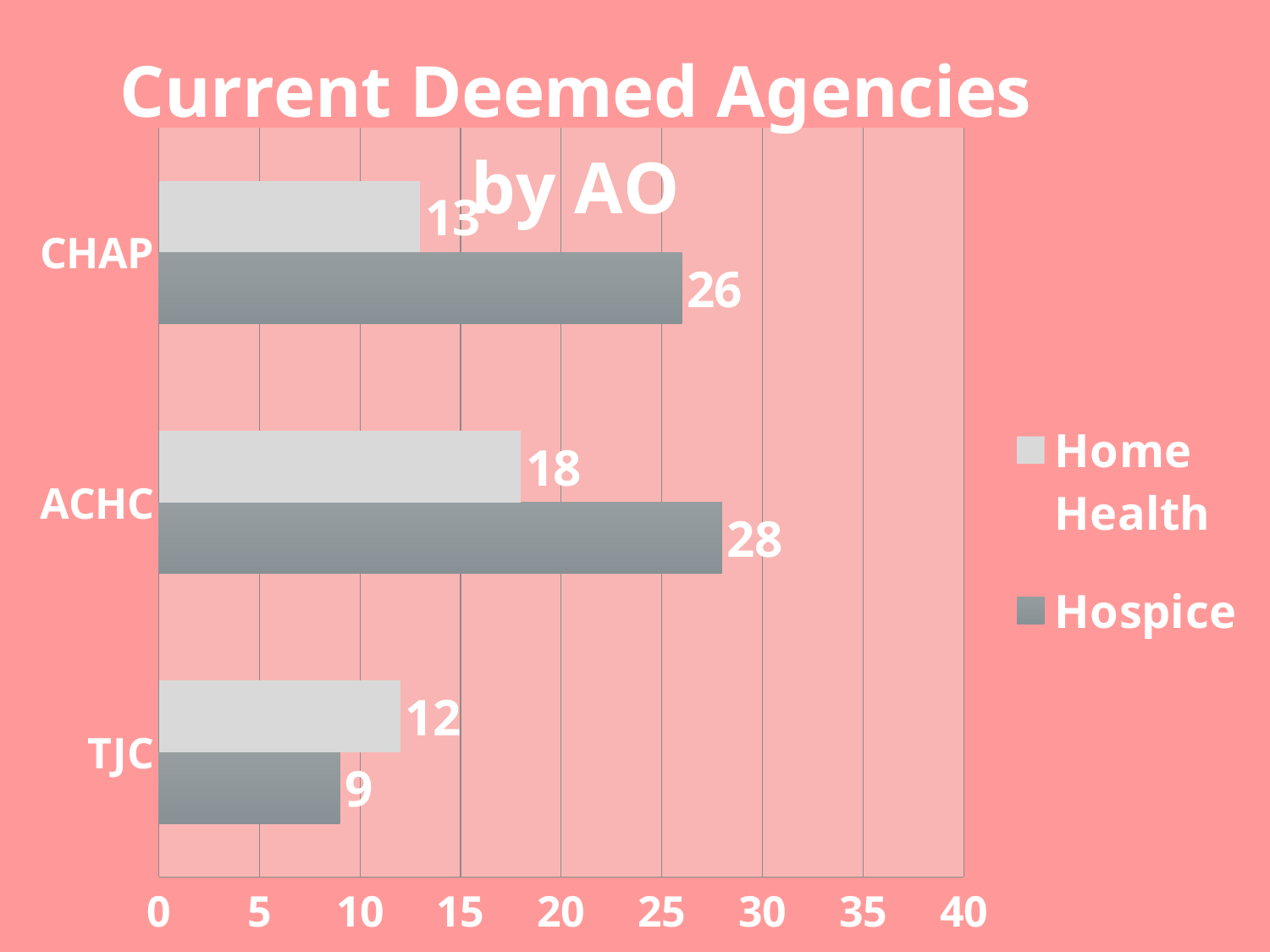
Which agency has the lowest Home Health value? TJC What is the difference between the Hospice and Home Health values for CHAP? 13 What is the Home Health value for CHAP? 13 What kind of chart is shown on the slide? bar chart What is the Hospice value for TJC? 9 Which agency has the highest Hospice value? ACHC How many series does the legend list? 2 Is the Hospice value for ACHC greater or less than 25? greater What is the title of the chart? Current Deemed Agencies by AO How many agencies are shown on the chart? 3 What is the Hospice value for ACHC? 28 Which is larger for TJC, Home Health or Hospice? Home Health